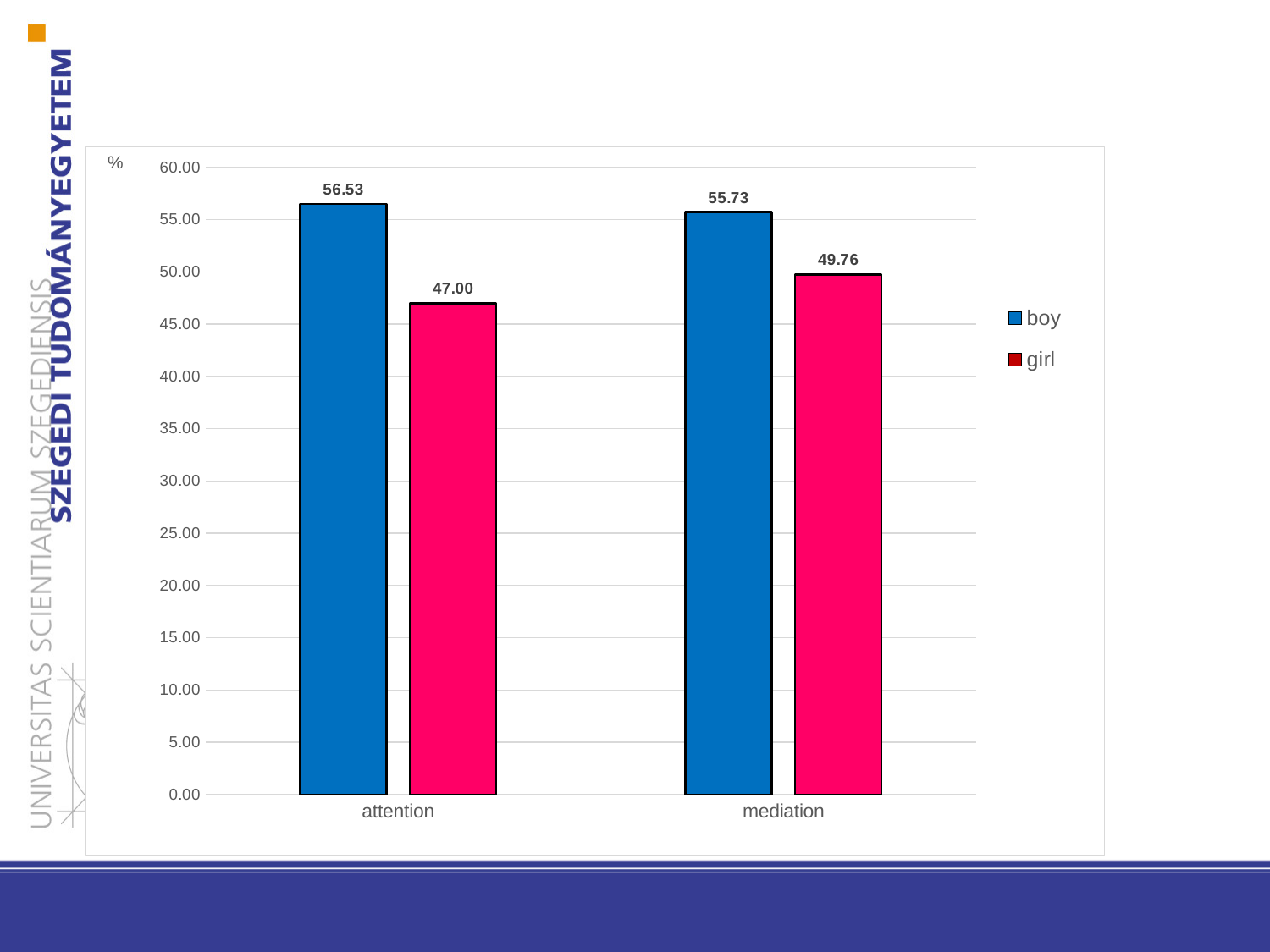
Which bar has the highest value on the chart? boy, attention What is the difference between the boy and girl values in the mediation category? 5.97 How many series does the legend list? 2 What kind of chart is shown on the slide? bar chart How many categories are shown on the x axis? 2 What is the difference between the boy and girl values in the attention category? 9.53 What is the value for girl in the mediation category? 49.76 Which is larger: the girl value for attention or the girl value for mediation? mediation What is the value for girl in the attention category? 47.00 What is the value for boy in the attention category? 56.53 What is the value for boy in the mediation category? 55.73 Which bar has the lowest value on the chart? girl, attention